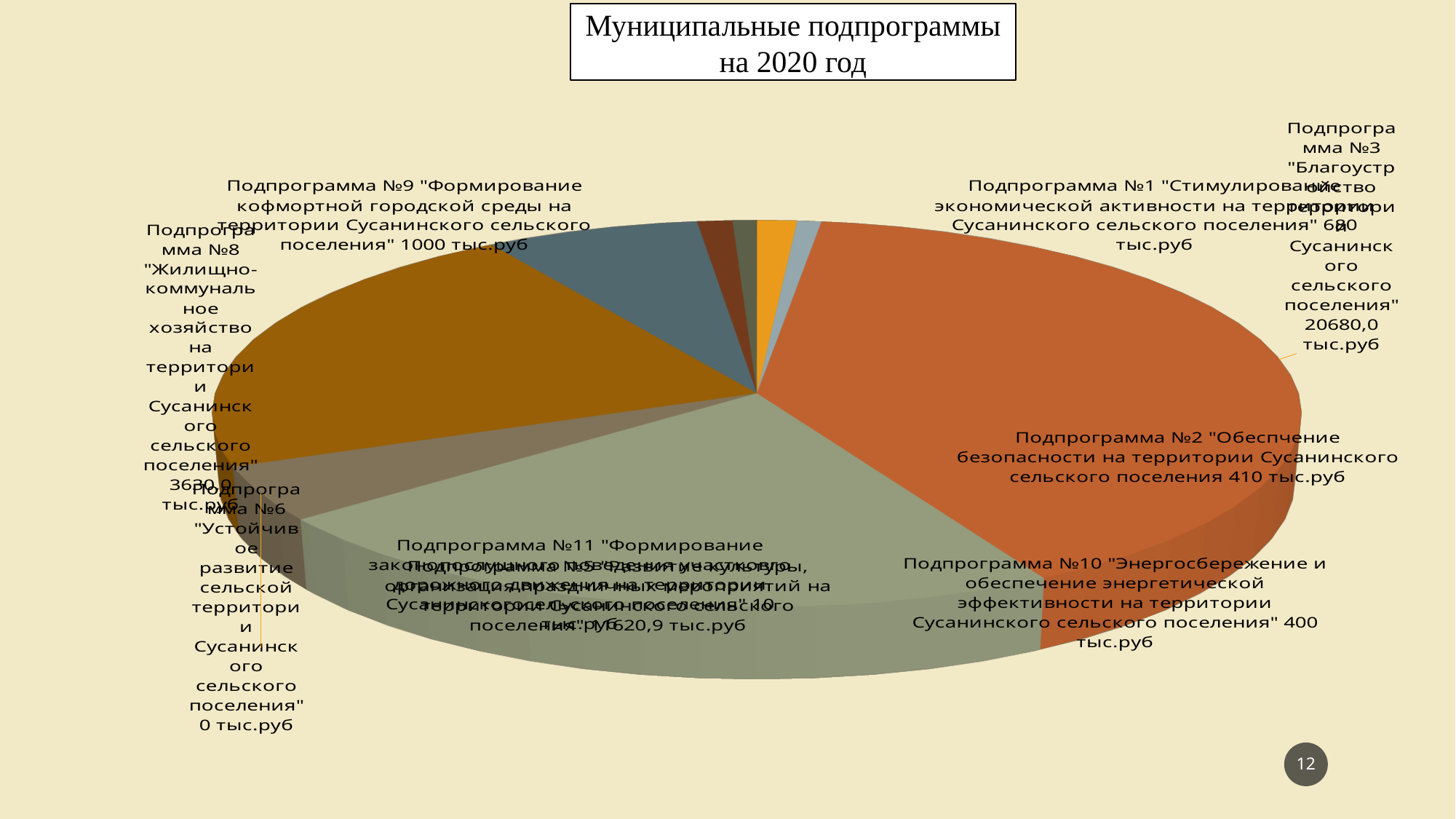
What is the value shown for Подпрограмма №2 "Обеспечение безопасности на территории Сусанинского сельского поселения"? 410 тыс.руб What is the difference between the values of Подпрограмма №9 and Подпрограмма №2? 590 тыс.руб What is the value shown for Подпрограмма №6 "Устойчивое развитие сельской территории"? 0 тыс.руб What kind of chart is shown on the slide? Pie chart Which subprogram has the largest slice of the pie? Подпрограмма №3 "Благоустройство территории Сусанинского сельского поселения" What is the value shown for Подпрограмма №3 "Благоустройство территории Сусанинского сельского поселения"? 20680,0 тыс.руб What is the value shown for Подпрограмма №10 "Энергосбережение и обеспечение энергетической эффективности"? 400 тыс.руб What is the title of the slide's chart? Муниципальные подпрограммы на 2020 год Which has a larger value, Подпрограмма №2 or Подпрограмма №10? Подпрограмма №2 Which subprogram has the smallest value on the chart? Подпрограмма №6 "Устойчивое развитие сельской территории" What is the value shown for Подпрограмма №9 "Формирование кофмортной городской среды"? 1000 тыс.руб